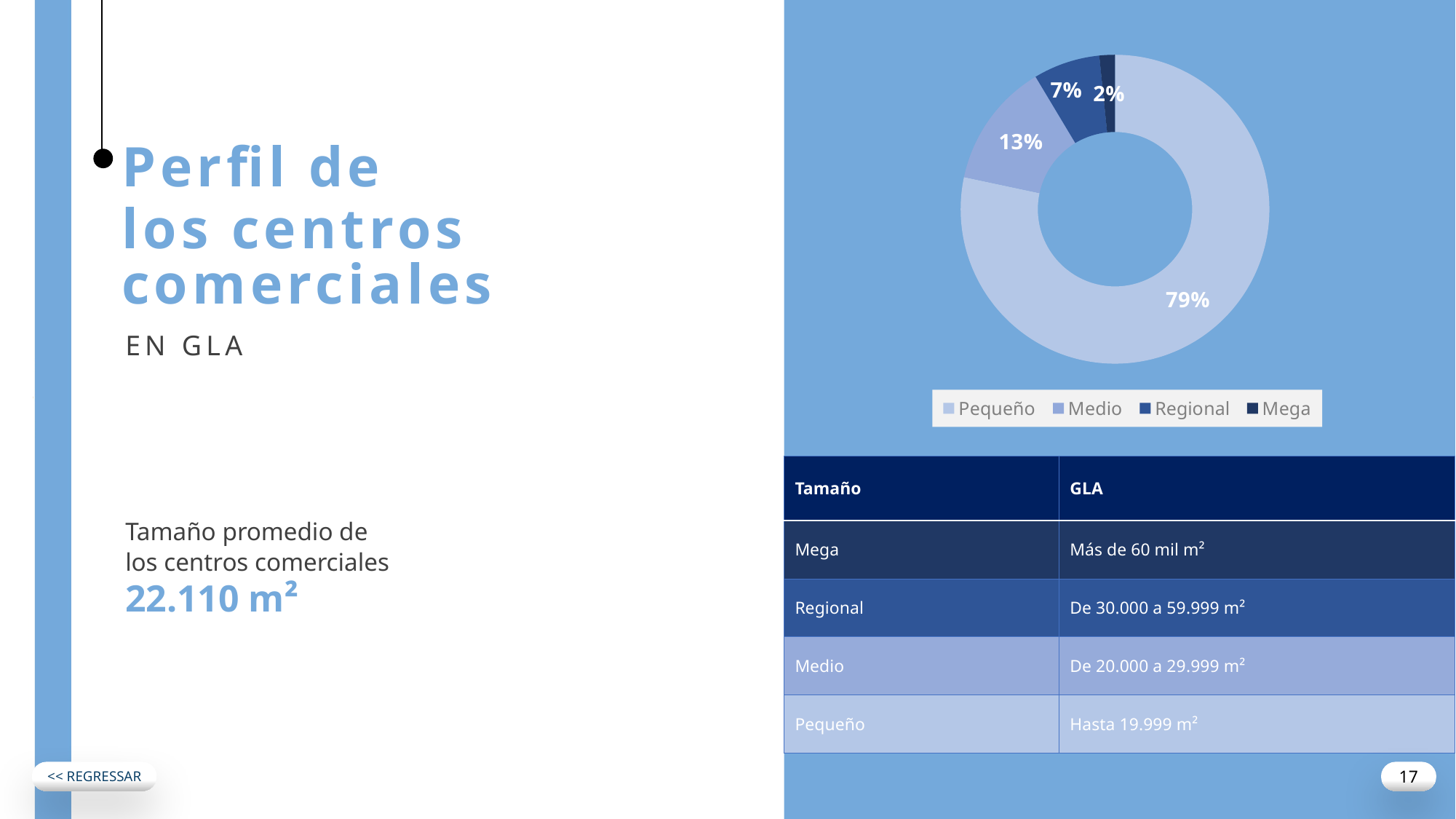
What percentage is shown for Regional in the donut chart? 7% How many categories are shown in the donut chart? 4 What is the difference in percentage points between Regional and Mega in the donut chart? 5 What share of the donut chart does Pequeño represent? 79% Which category has the smallest share in the donut chart? Mega Which has a larger share in the donut chart, Medio or Regional? Medio What is the difference in percentage points between Pequeño and Medio in the donut chart? 66 What percentage is shown for Mega in the donut chart? 2% Which category has the largest share in the donut chart? Pequeño What type of chart is shown on the slide? Donut (pie) chart What percentage is shown for Medio in the donut chart? 13% What are the legend entries of the donut chart, in order? Pequeño, Medio, Regional, Mega